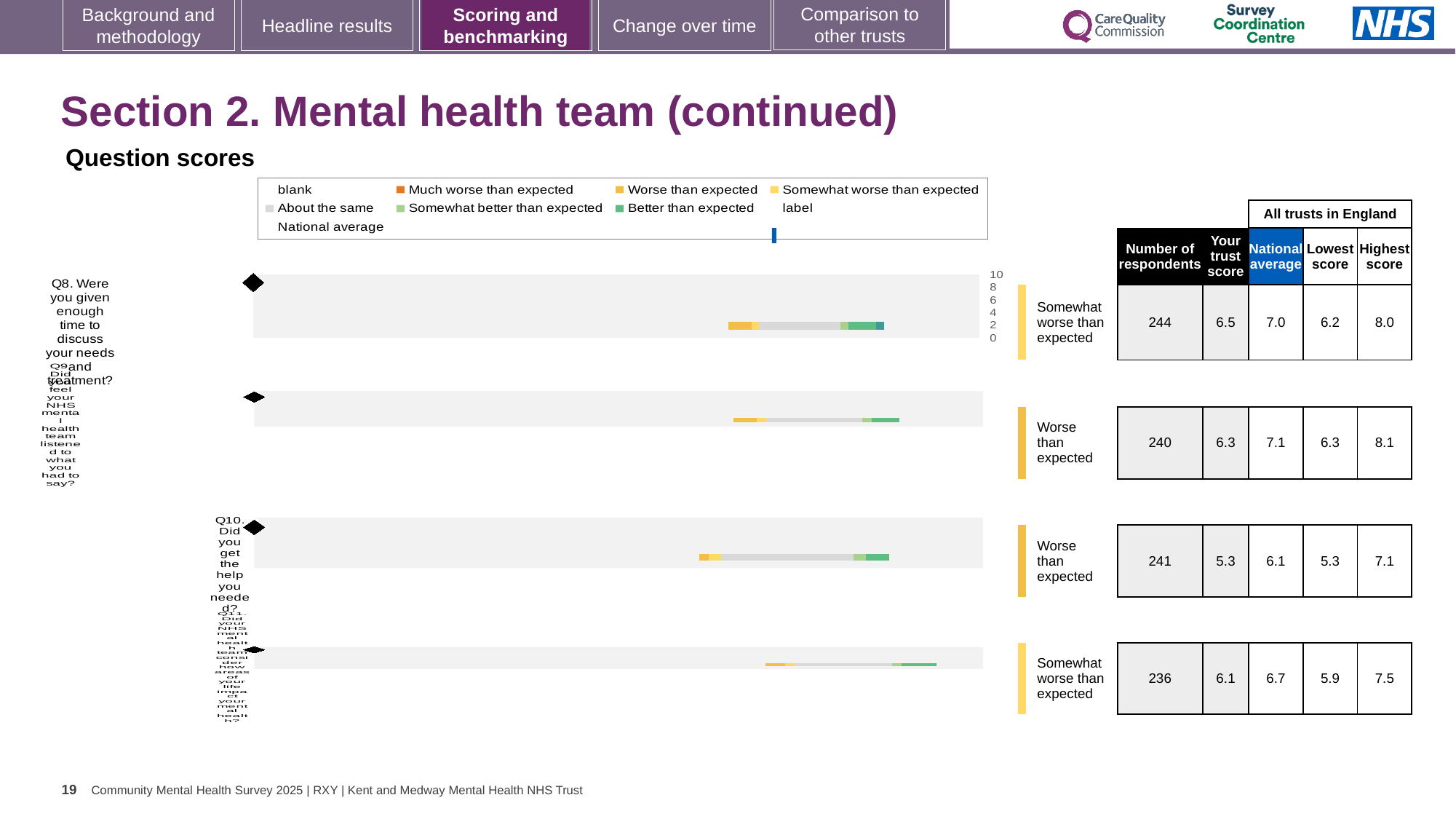
For the Q8 chart, what is the national average shown in the table? 7.0 For the Q10 chart (did you get the help you needed), what is the highest score among all trusts in England? 7.1 For the Q8 chart, which is larger: the trust score or the national average? national average For the Q8 chart, how many respondents are listed? 244 In the legend, which colour represents 'Much worse than expected'? orange Across the four question charts, which question has the lowest trust score in the table? Q10 What is the highest tick value on the axis of the Q8 chart? 10 How many question-score charts are shown on the slide? 4 What kind of chart is used for the Q8 question score? bar chart For the Q8 chart, what is the difference between the national average and the trust score? 0.5 Across the four question charts, which question has the highest trust score in the table? Q8 For the Q8 chart (enough time to discuss needs and treatment), what is the trust score shown in the table? 6.5